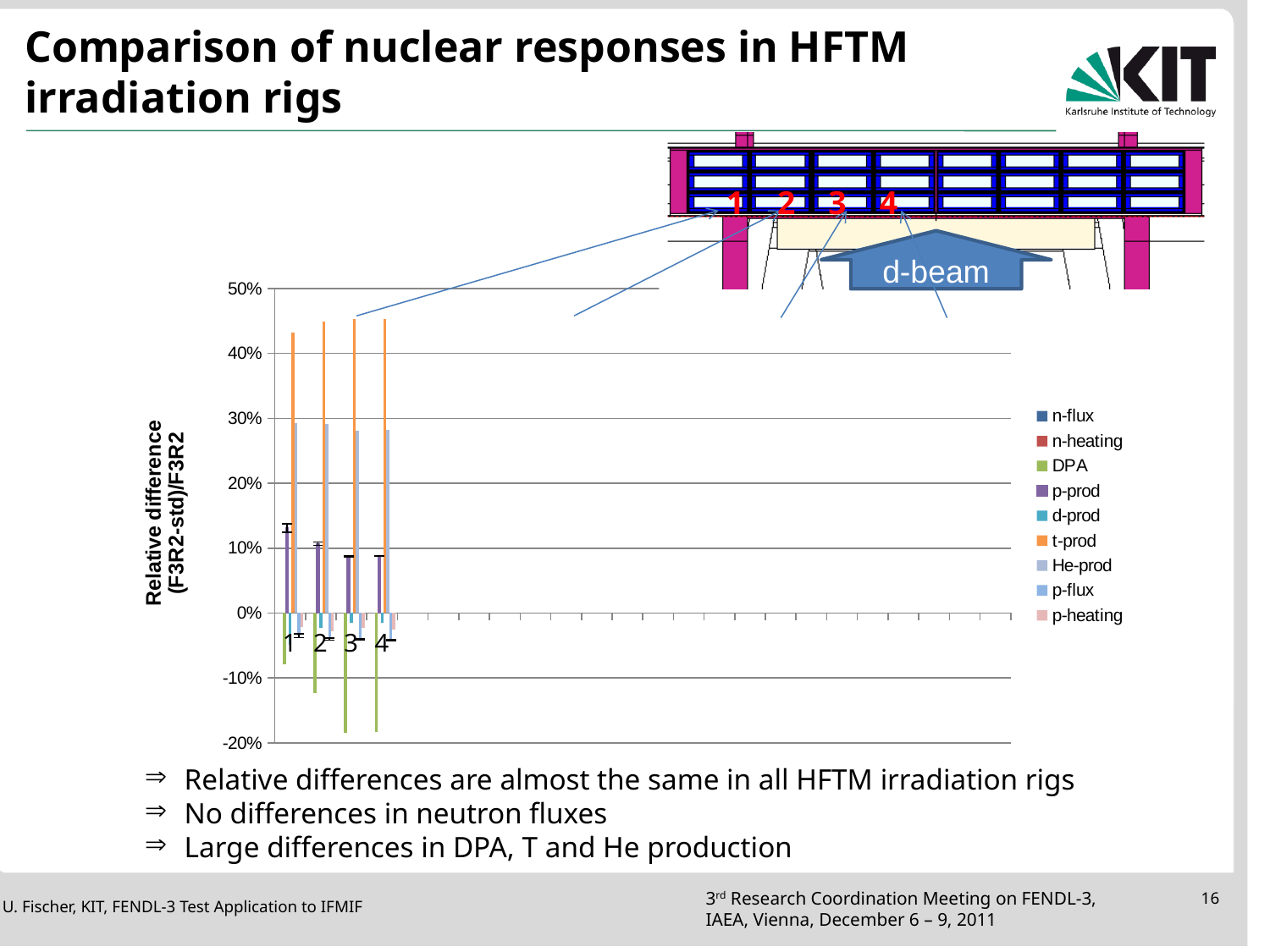
How many irradiation rig categories are plotted along the x axis? 4 Is the He-prod value for rig 2 greater or less than 20%? greater Which series is listed first in the legend? n-flux Is the DPA value for rig 3 greater or less than -10%? less What kind of chart is shown on the slide? bar chart For rig 2, which is larger: the t-prod value or the He-prod value? t-prod How many series does the chart legend list? 9 Is the t-prod value for rig 1 greater or less than 40%? greater Which series has the lowest value for rig 3? DPA Which series has the highest value for rig 1? t-prod What is the title of the vertical axis? Relative difference (F3R2-std)/F3R2